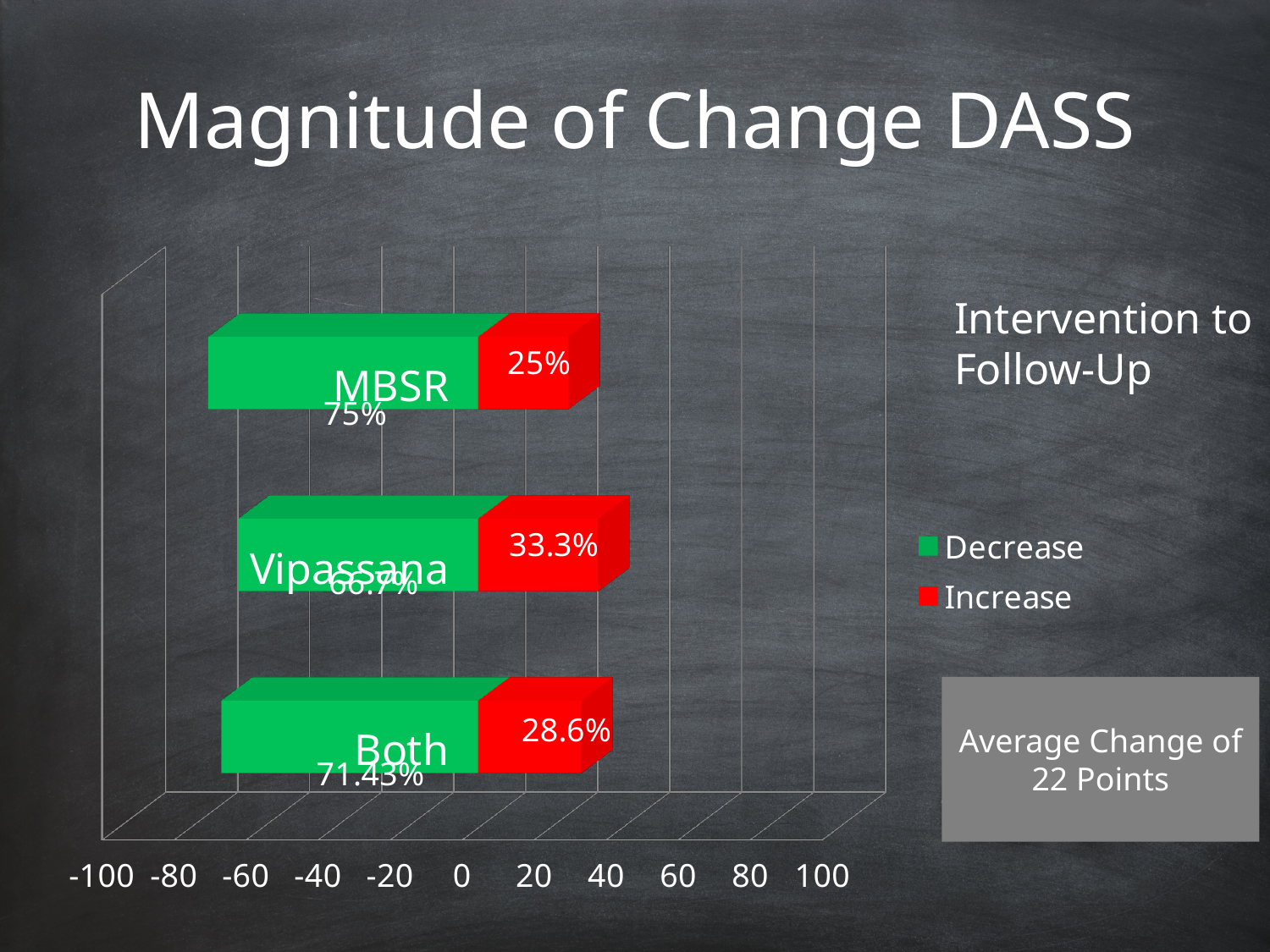
What is the Increase value for MBSR? 25% Which intervention has the lowest Increase value? MBSR What is the difference between the Increase values for Vipassana and MBSR? 8.3% What is the Decrease value for MBSR? 75% What is the Increase value for Vipassana? 33.3% How many series does the legend list? 2 How many categories (interventions) are shown in the chart? 3 What is the Decrease value for Both? 71.43% Which colour represents the Decrease series in the legend? green Which intervention has the highest Increase value? Vipassana What kind of chart is shown on the slide? bar chart What is the Increase value for Both? 28.6%